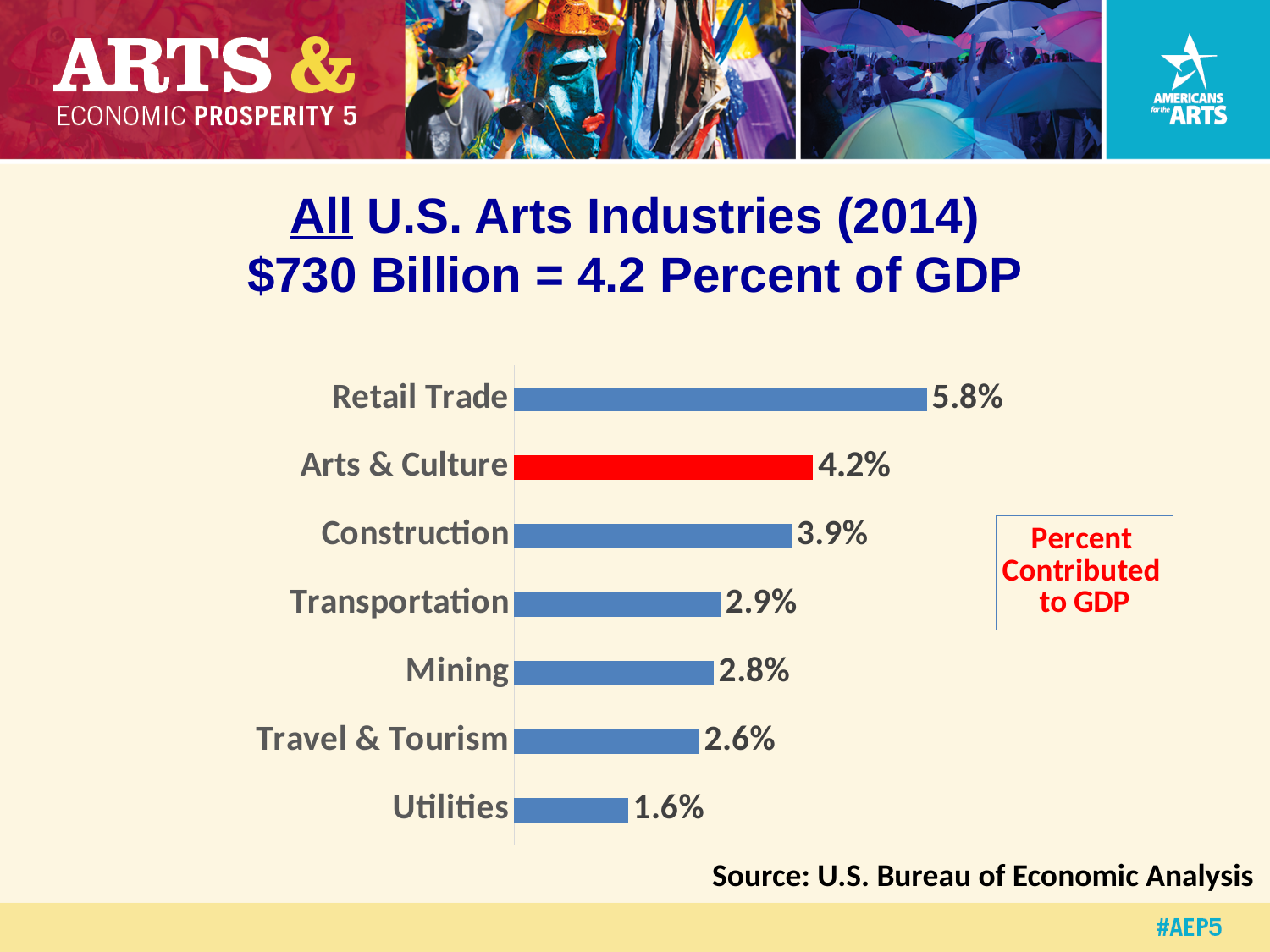
What is the difference between the values for Retail Trade and Arts & Culture? 1.6% Which is larger, the value for Arts & Culture or the value for Construction? Arts & Culture What kind of chart is shown on the slide? Bar chart Which industry has the highest percent contributed to GDP? Retail Trade What is the difference between the values for Transportation and Travel & Tourism? 0.3% What is the source cited for the chart data? U.S. Bureau of Economic Analysis What is the value shown for Utilities? 1.6% What is the value shown for Construction? 3.9% Which bar in the chart is coloured red? Arts & Culture Which industry has the lowest percent contributed to GDP? Utilities How many industries are shown in the chart? 7 What percent of GDP does Arts & Culture contribute according to the chart? 4.2%